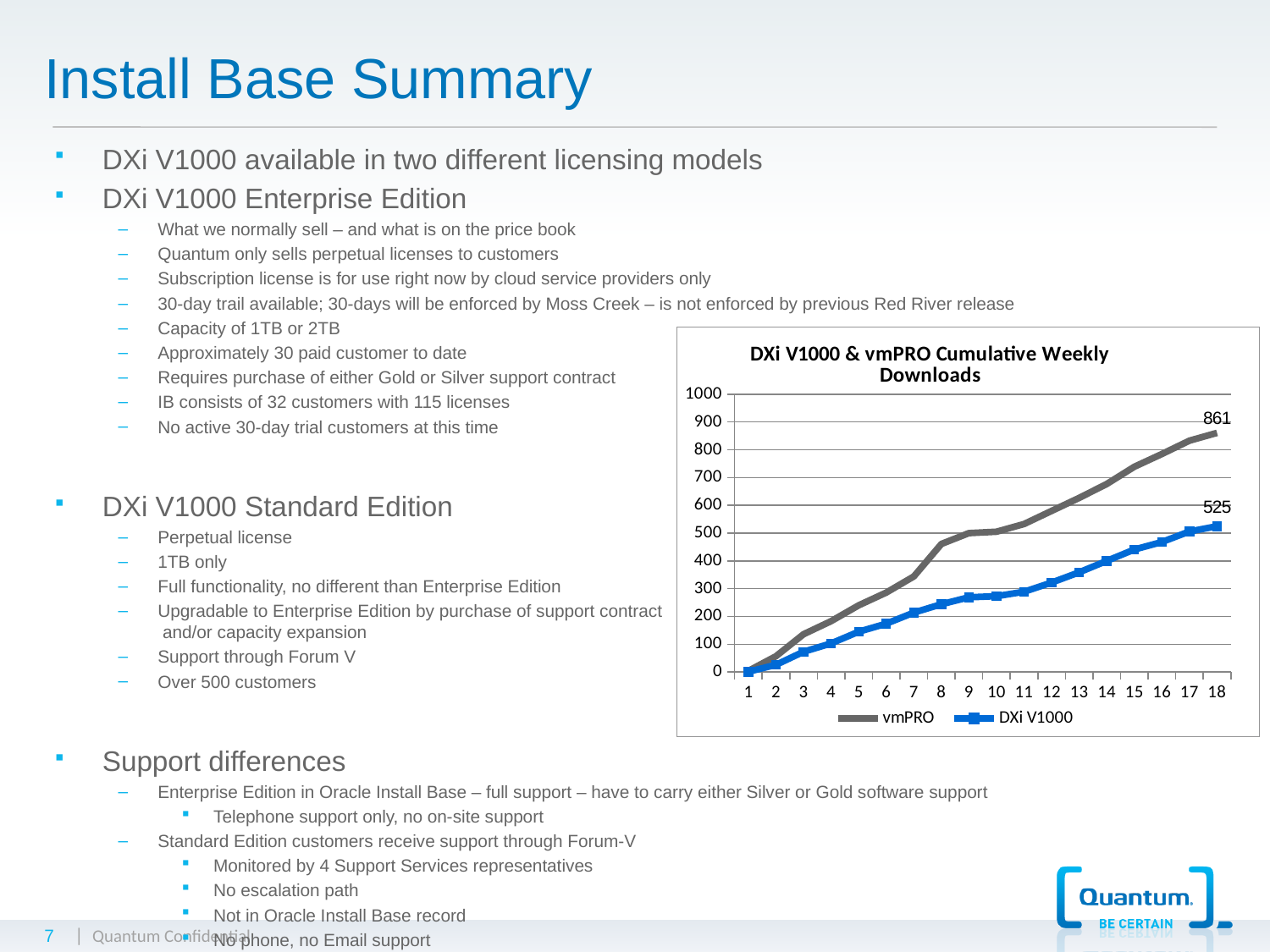
Which two series are listed in the chart's legend? vmPRO and DXi V1000 Is the value for DXi V1000 at week 9 greater or less than 200? greater What is the value for DXi V1000 at week 18? 525 Is the value for vmPRO at week 12 greater or less than 700? less What is the value for vmPRO at week 18? 861 Which series has the higher value at week 18, vmPRO or DXi V1000? vmPRO What is the difference between the vmPRO and DXi V1000 values at week 18? 336 How many weeks are plotted along the x axis? 18 How many series does the chart's legend list? 2 What kind of chart is shown on the slide? line chart What is the title of the chart? DXi V1000 & vmPRO Cumulative Weekly Downloads Do the vmPRO values rise or fall from week 1 to week 18? rise